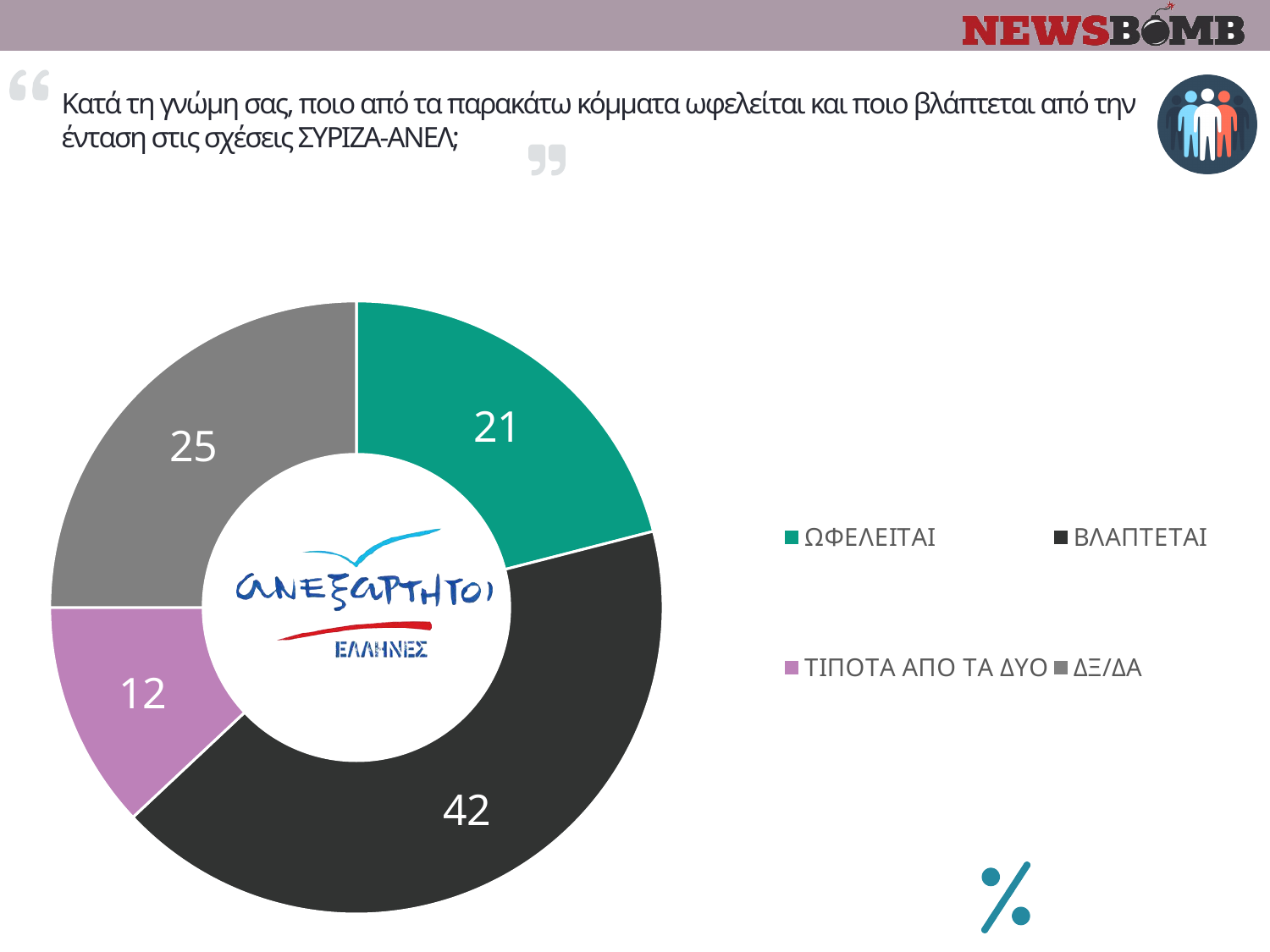
What is the difference between the values for ΔΞ/ΔΑ and ΤΙΠΟΤΑ ΑΠΟ ΤΑ ΔΥΟ? 13 What value is shown for ΔΞ/ΔΑ in the chart? 25 Which category has the smallest value in the chart? ΤΙΠΟΤΑ ΑΠΟ ΤΑ ΔΥΟ How many categories does the chart show? 4 What value is shown for ΒΛΑΠΤΕΤΑΙ in the chart? 42 Which colour represents ΤΙΠΟΤΑ ΑΠΟ ΤΑ ΔΥΟ in the chart? Purple What value is shown for ΤΙΠΟΤΑ ΑΠΟ ΤΑ ΔΥΟ in the chart? 12 What is the difference between the values for ΒΛΑΠΤΕΤΑΙ and ΩΦΕΛΕΙΤΑΙ? 21 What kind of chart is shown on the slide? Doughnut (pie) chart Which is larger, the value for ΔΞ/ΔΑ or the value for ΩΦΕΛΕΙΤΑΙ? ΔΞ/ΔΑ What value is shown for ΩΦΕΛΕΙΤΑΙ in the chart? 21 Which category has the largest value in the chart? ΒΛΑΠΤΕΤΑΙ